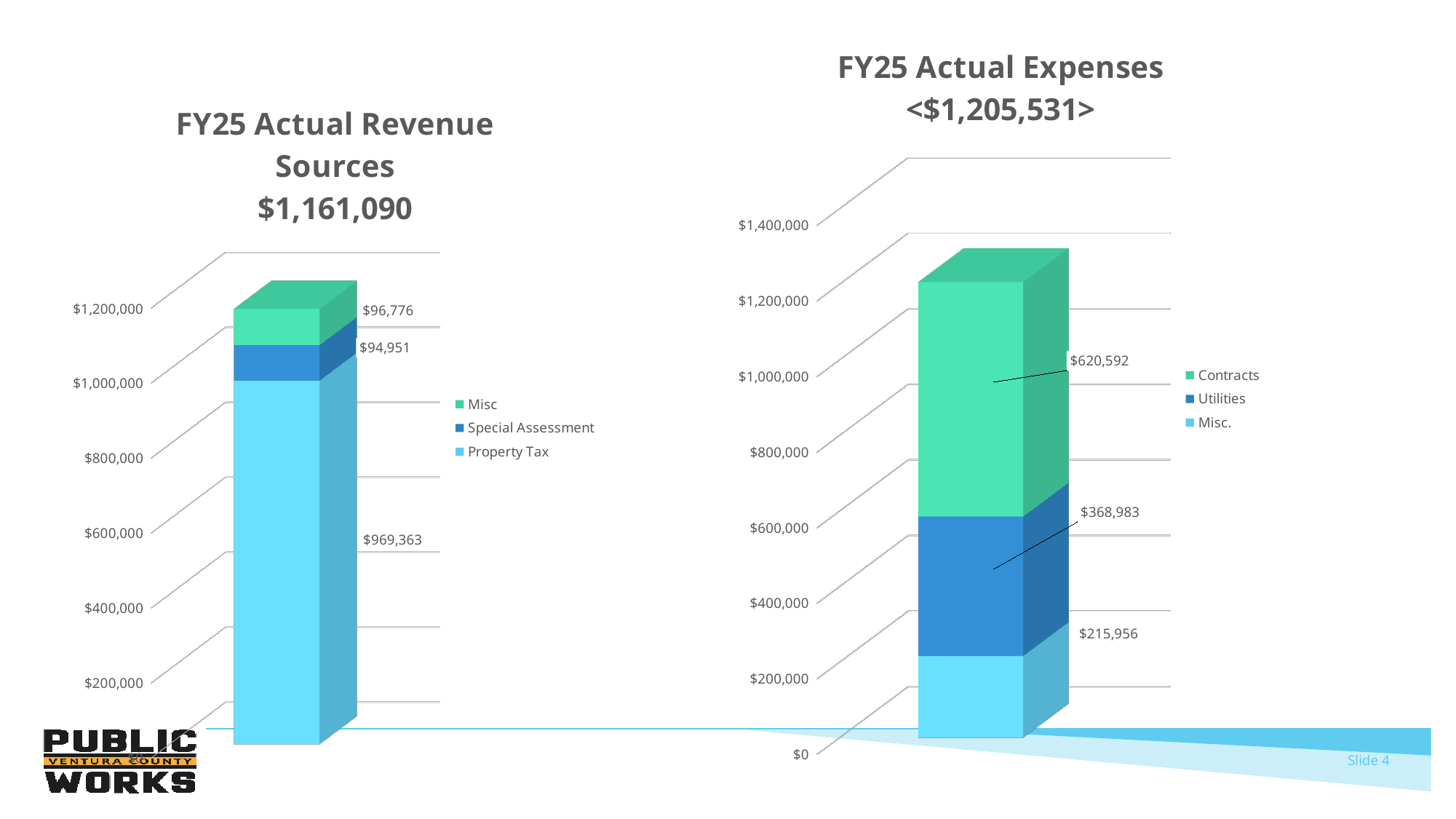
In the FY25 Actual Expenses chart, what is the value for Utilities? $368,983 In the FY25 Actual Expenses chart, what is the value for Misc.? $215,956 In the FY25 Actual Expenses chart, which series has the smallest value? Misc. What kind of chart is the FY25 Actual Expenses chart? Stacked bar chart How many series does the legend of the FY25 Actual Revenue Sources chart list? 3 In the FY25 Actual Revenue Sources chart, what is the value for Property Tax? $969,363 In the FY25 Actual Expenses chart, what is the value for Contracts? $620,592 In the FY25 Actual Revenue Sources chart, which series has the largest value? Property Tax In the FY25 Actual Revenue Sources chart, what is the value for Special Assessment? $94,951 In the FY25 Actual Revenue Sources chart, what is the value for Misc? $96,776 In the FY25 Actual Expenses chart, what is the difference between Contracts and Utilities? $251,609 In the FY25 Actual Expenses chart, what is the total of the stacked bar? $1,205,531